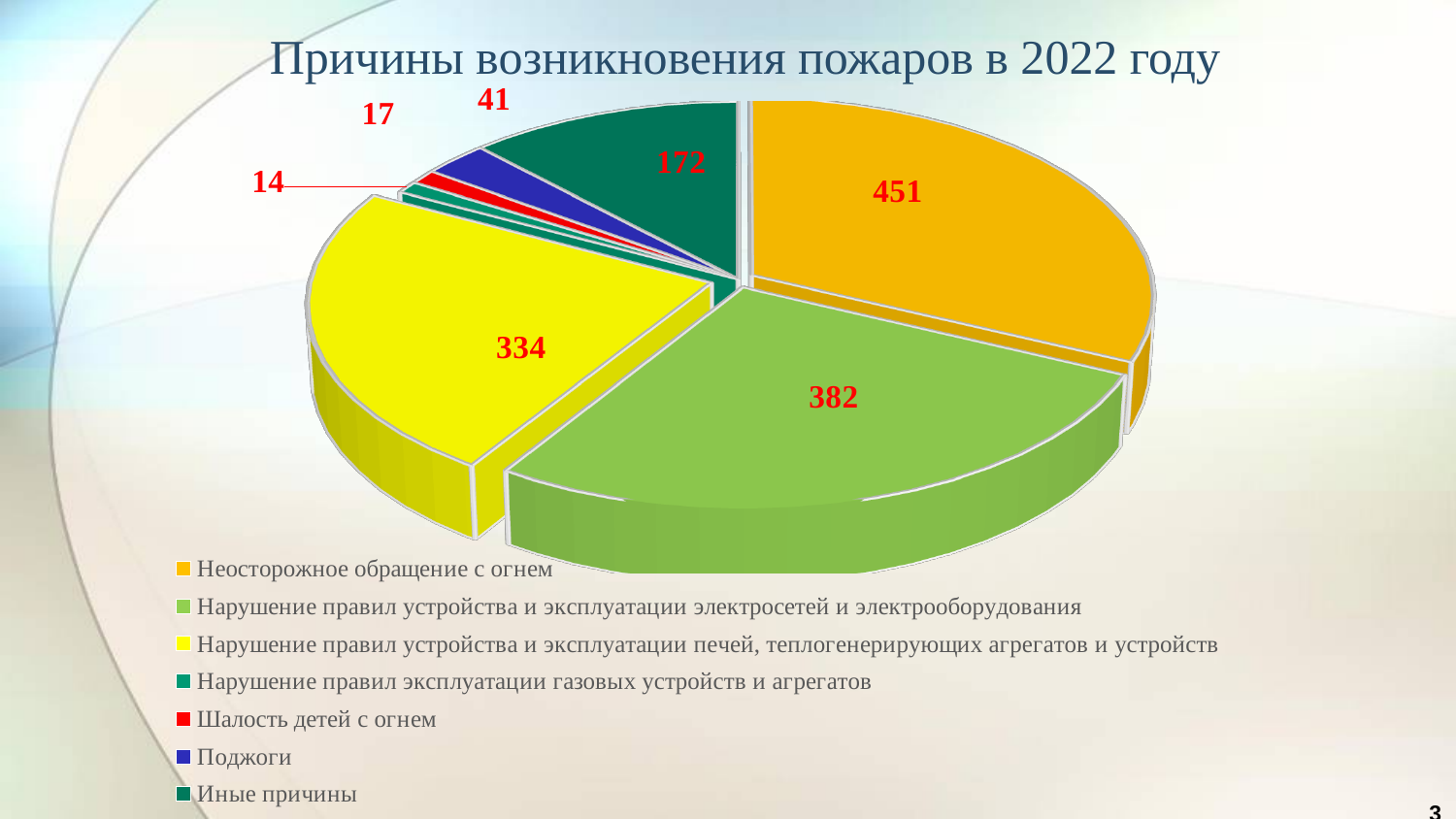
What is the value for "Неосторожное обращение с огнем"? 451 What is the value for "Поджоги"? 41 Which category has the largest value? Неосторожное обращение с огнем What is the difference between the values for "Неосторожное обращение с огнем" and "Нарушение правил устройства и эксплуатации электросетей и электрооборудования"? 69 Which category has the smallest value? Нарушение правил эксплуатации газовых устройств и агрегатов What is the value for "Нарушение правил устройства и эксплуатации электросетей и электрооборудования"? 382 What is the title of the chart? Причины возникновения пожаров в 2022 году Which is larger: the value for "Шалость детей с огнем" or the value for "Поджоги"? Поджоги What type of chart is shown on the slide? Pie chart What is the value for "Иные причины"? 172 What is the value for "Нарушение правил устройства и эксплуатации печей, теплогенерирующих агрегатов и устройств"? 334 How many categories (slices) does the pie chart have? 7